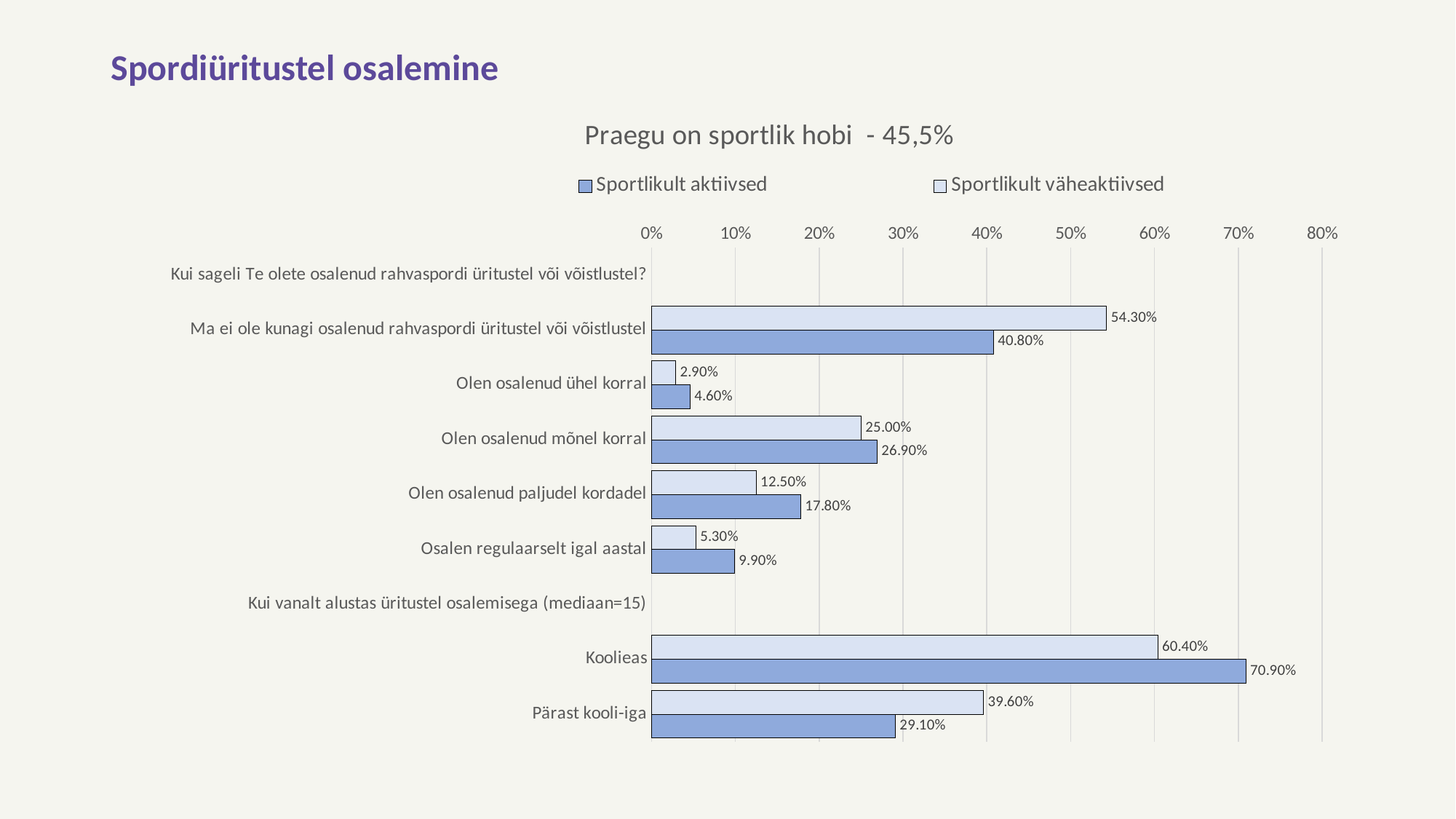
For "Olen osalenud paljudel kordadel", which series has the larger value: "Sportlikult aktiivsed" or "Sportlikult väheaktiivsed"? Sportlikult aktiivsed What is the value for "Sportlikult aktiivsed" in the category "Osalen regulaarselt igal aastal"? 9.90% Is the value for "Sportlikult aktiivsed" in "Ma ei ole kunagi osalenud rahvaspordi üritustel või võistlustel" greater or less than 50%? less What kind of chart is shown on the slide? bar chart What is the value for "Sportlikult aktiivsed" in the category "Koolieas"? 70.90% What is the value for "Sportlikult väheaktiivsed" in the category "Pärast kooli-iga"? 39.60% What is the value for "Sportlikult väheaktiivsed" in the category "Ma ei ole kunagi osalenud rahvaspordi üritustel või võistlustel"? 54.30% What is the difference between the "Sportlikult aktiivsed" and "Sportlikult väheaktiivsed" values for "Koolieas"? 10.50% What is the title of the chart? Praegu on sportlik hobi - 45,5% How many series does the legend list? 2 Which category has the lowest value for "Sportlikult väheaktiivsed"? Olen osalenud ühel korral Which category has the highest value for "Sportlikult aktiivsed"? Koolieas